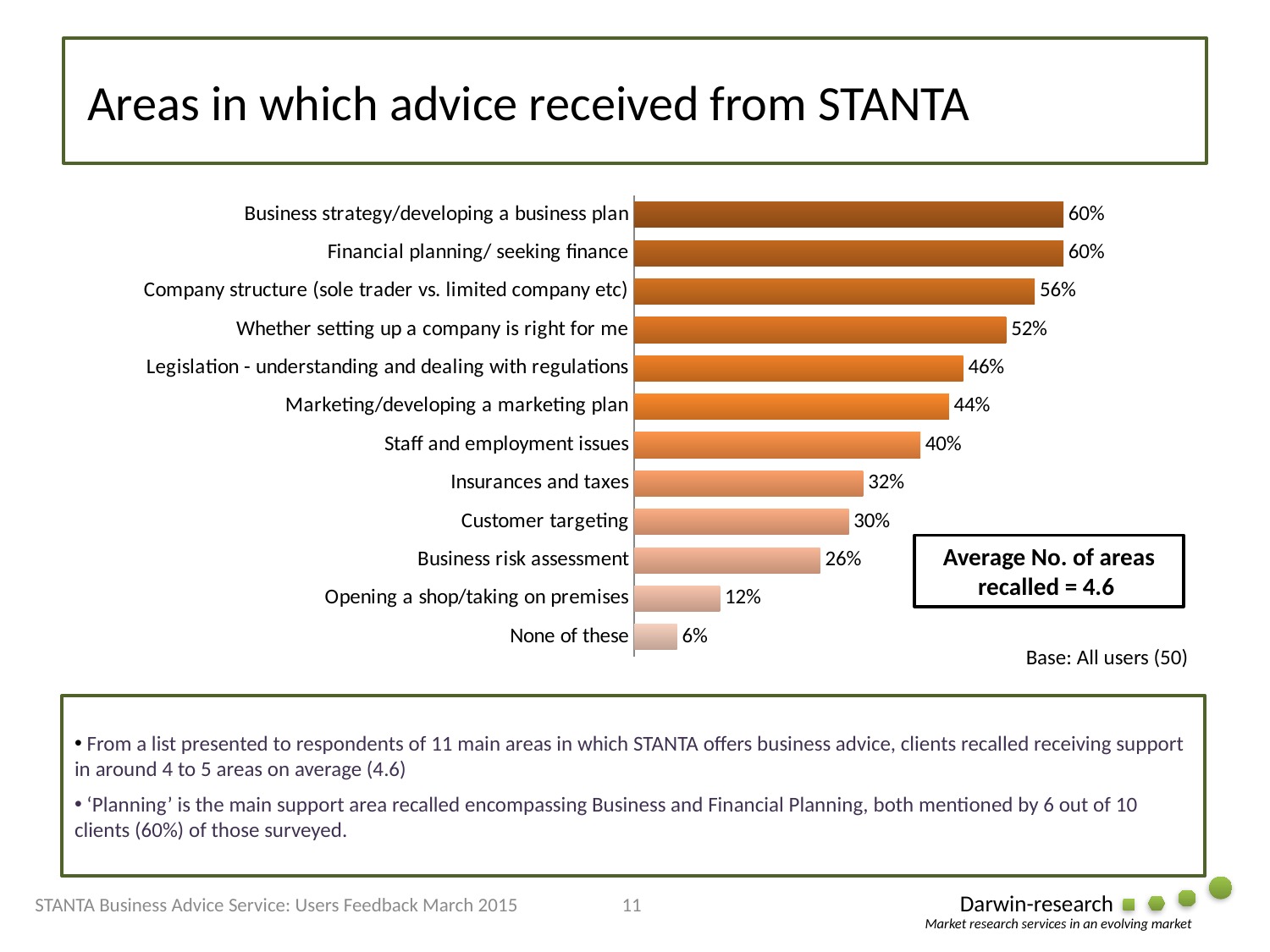
How many categories are shown in the chart? 12 What is the difference between the values for Company structure (sole trader vs. limited company etc) and Customer targeting? 26% Which is larger: the value for Legislation - understanding and dealing with regulations or the value for Insurances and taxes? Legislation - understanding and dealing with regulations What percentage is shown for Opening a shop/taking on premises? 12% What is the difference between the values for Whether setting up a company is right for me and Business risk assessment? 26% What percentage of users received advice on Marketing/developing a marketing plan? 44% Which category has the lowest value in the chart? None of these What is the highest value shown in the chart? 60% What is the average number of areas recalled, as stated in the box on the chart? 4.6 What kind of chart is shown on the slide? Bar chart What is the title of the chart on the slide? Areas in which advice received from STANTA What is the value for Staff and employment issues? 40%